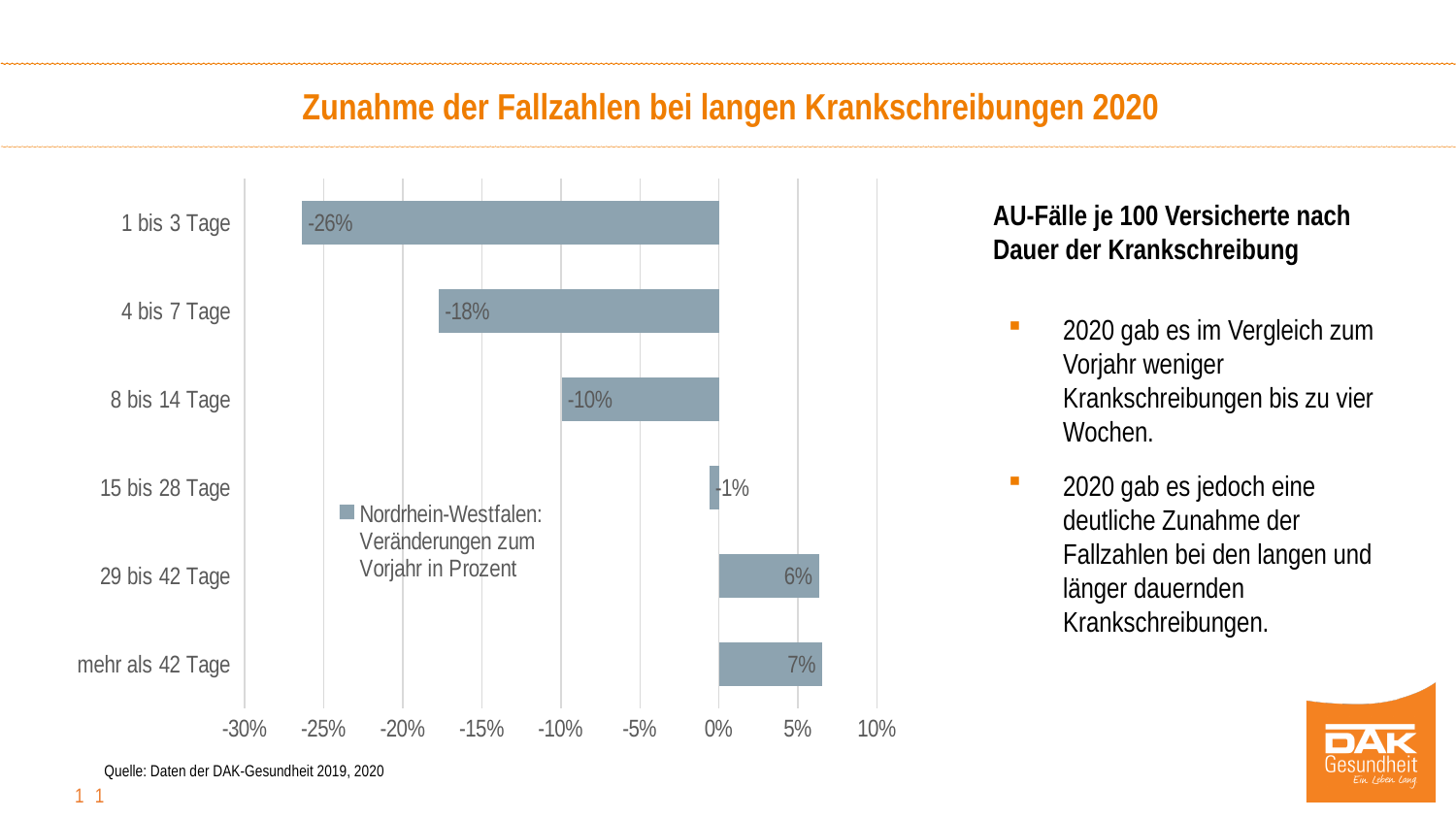
Which is larger, the value for "29 bis 42 Tage" or the value for "15 bis 28 Tage"? 29 bis 42 Tage What is the title of the chart on the slide? Zunahme der Fallzahlen bei langen Krankschreibungen 2020 What is the value for "4 bis 7 Tage"? -18% What is the value for "1 bis 3 Tage"? -26% What is the value for "mehr als 42 Tage"? 7% Which category has the lowest value? 1 bis 3 Tage Which category has the highest value? mehr als 42 Tage What is the value for "8 bis 14 Tage"? -10% How many categories are shown in the chart? 6 How many series does the legend list? 1 What is the difference between the values for "1 bis 3 Tage" and "4 bis 7 Tage"? 8 percentage points What kind of chart is shown on the slide? Bar chart